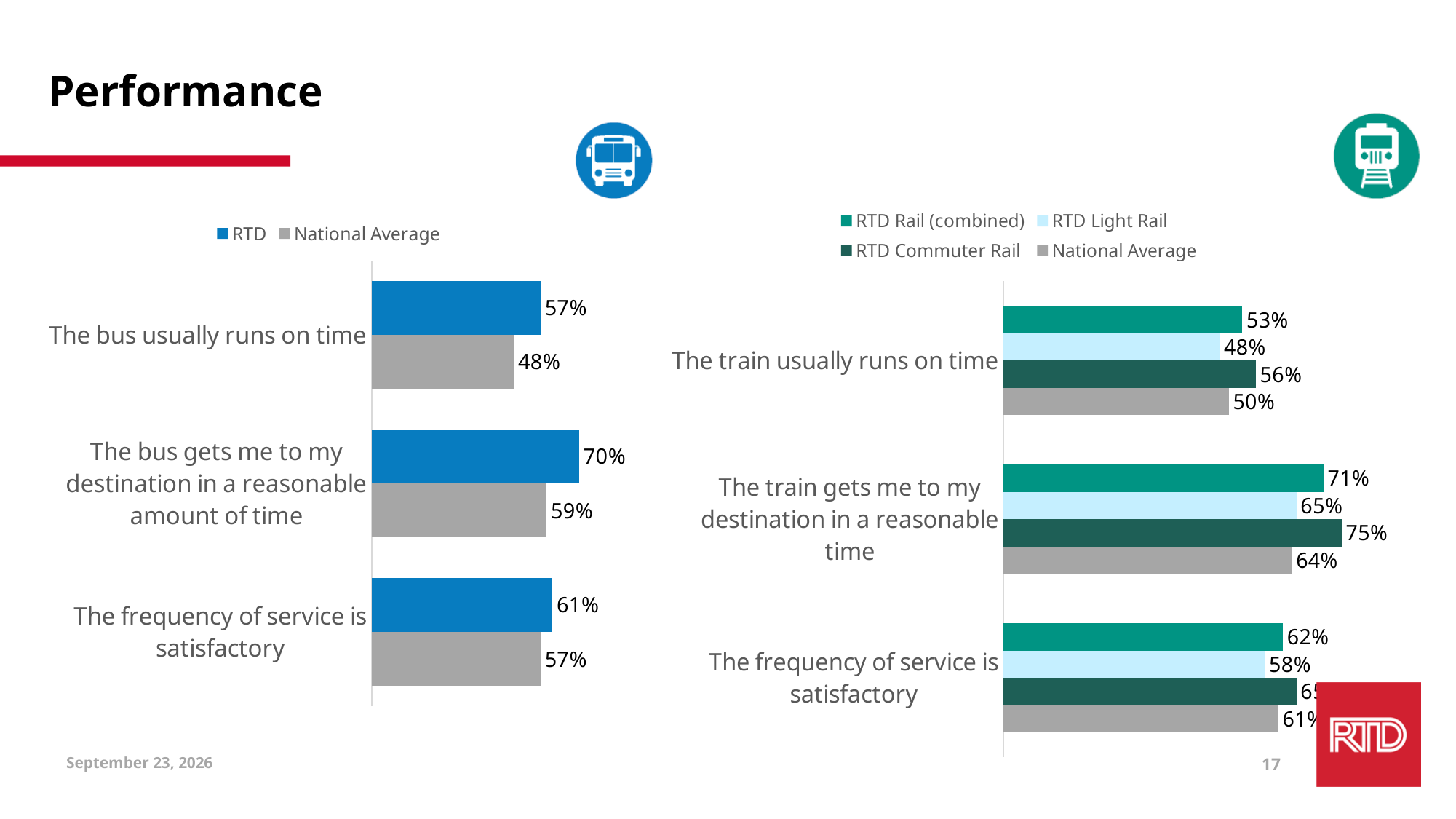
In the left chart (bus), which category has the highest RTD value? The bus gets me to my destination in a reasonable amount of time In the right chart (train), how many series does the legend list? 4 What kind of chart is the left chart (bus)? Bar chart In the right chart (train), what is the RTD Light Rail value for "The train gets me to my destination in a reasonable time"? 65% In the right chart (train), which series has the highest value for "The train gets me to my destination in a reasonable time"? RTD Commuter Rail In the right chart (train), what is the difference between the RTD Rail (combined) and National Average values for "The train gets me to my destination in a reasonable time"? 7% In the left chart (bus), how many series does the legend list? 2 In the right chart (train), what is the RTD Commuter Rail value for "The train usually runs on time"? 56% In the left chart (bus), what is the RTD value for "The bus usually runs on time"? 57% In the left chart (bus), what is the difference between the RTD and National Average values for "The bus usually runs on time"? 9% In the left chart (bus), what is the National Average value for "The bus gets me to my destination in a reasonable amount of time"? 59% In the right chart (train), which is larger for "The train usually runs on time": RTD Light Rail or National Average? National Average